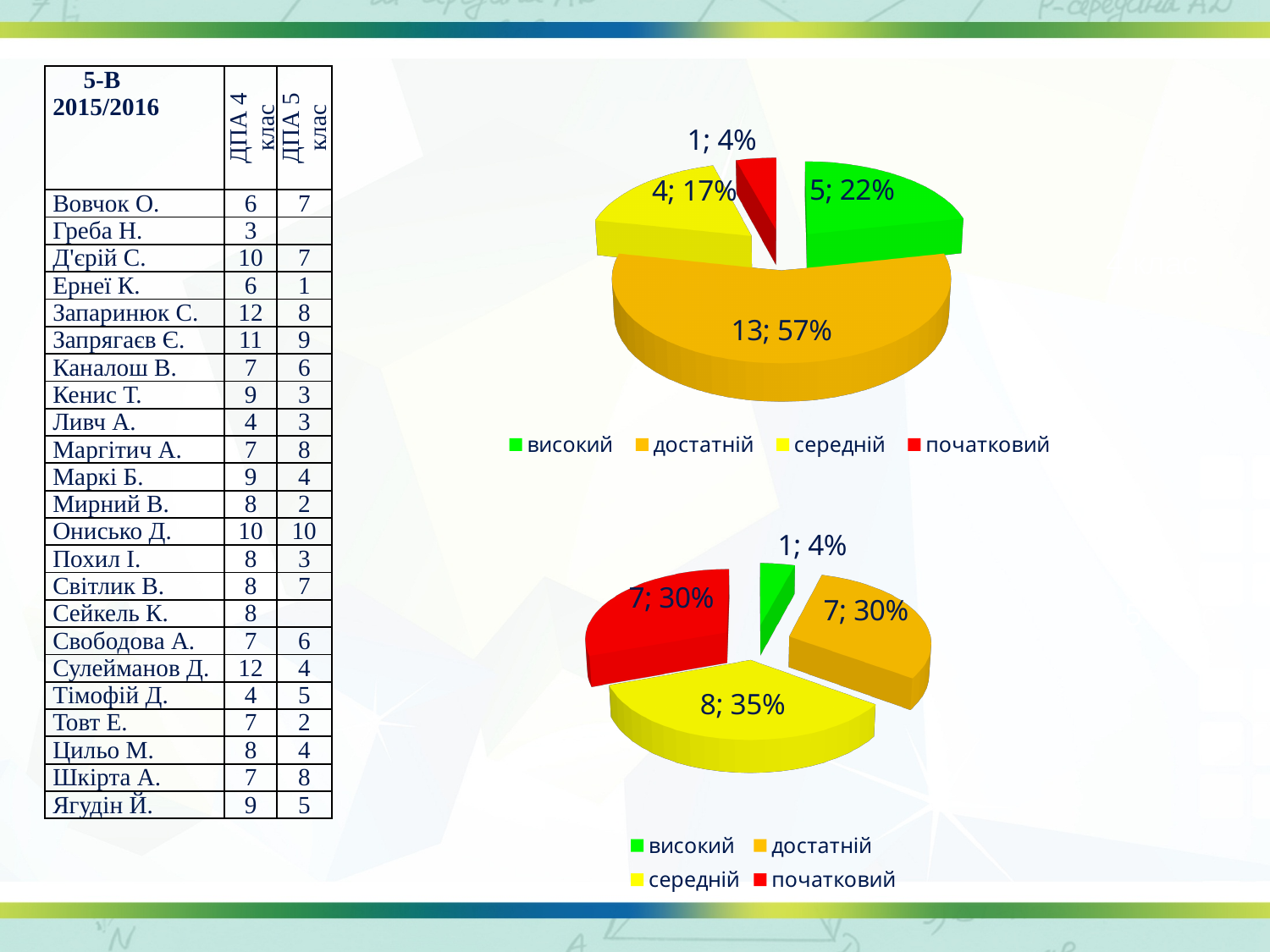
In the bottom pie chart, which is larger: the count for середній or the count for достатній? середній In the bottom pie chart, which category has the smallest slice? високий What type of chart is the bottom chart on the slide? pie chart In the bottom pie chart, what share of the pie does the початковий slice represent? 30% In the top pie chart, which category has the largest slice? достатній In the top pie chart, what is the difference between the count for достатній and the count for середній? 9 In the bottom pie chart, which category has the largest slice? середній How many categories does the legend of the top pie chart list? 4 In the top pie chart, what share of the pie does the високий slice represent? 22% In the top pie chart, what value and share are shown for the достатній slice? 13; 57% In the bottom pie chart, what value and share are shown for the середній slice? 8; 35% In the top pie chart, which category has the smallest slice? початковий